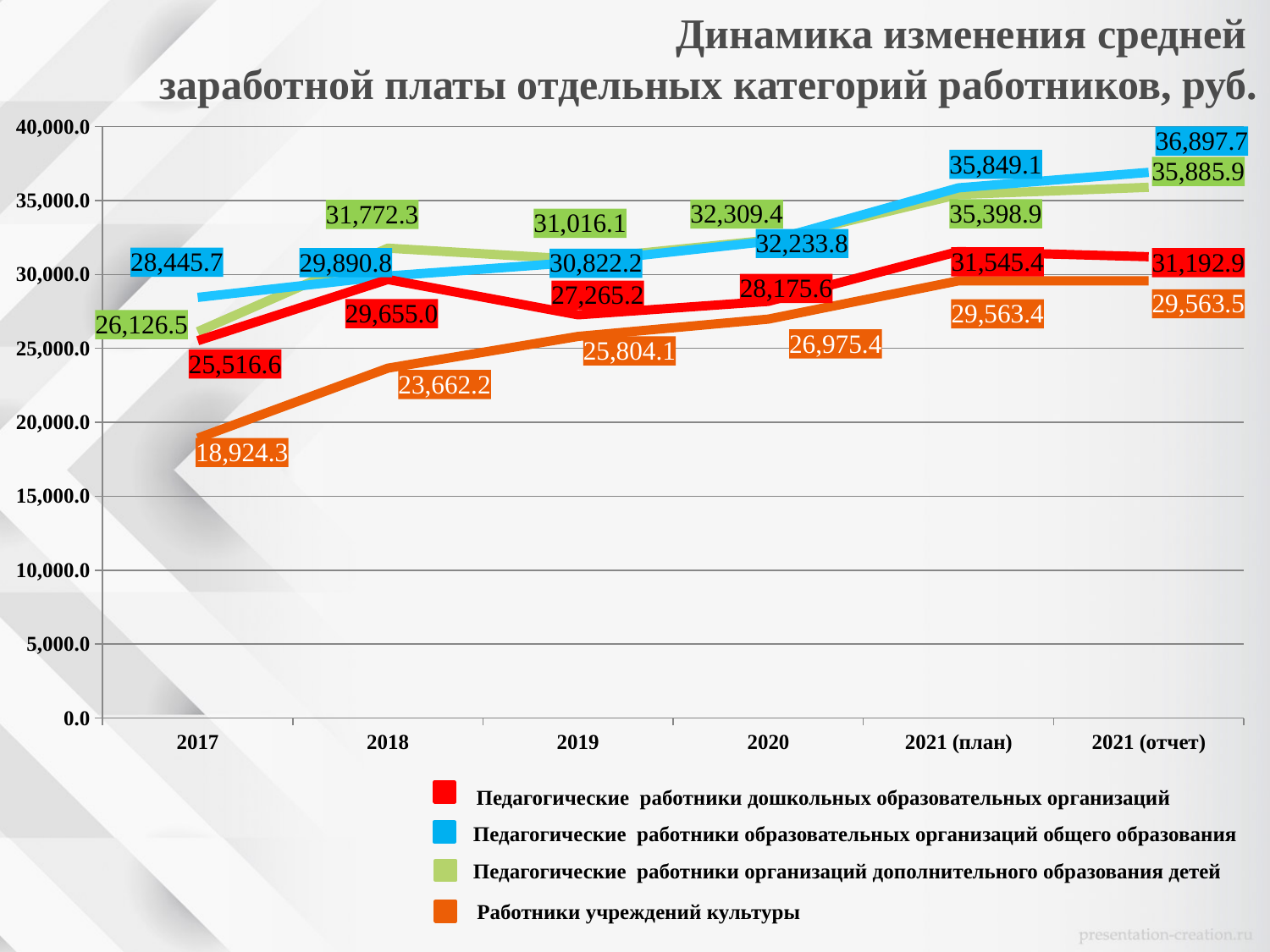
How many points along the x axis does the chart have? 6 What type of chart is shown on the slide? Line chart What is the value for Педагогические работники образовательных организаций общего образования in 2021 (отчет)? 36,897.7 How many series does the legend list? 4 Does the value for Работники учреждений культуры rise or fall from 2017 to 2021 (план)? Rise Which series has the lowest value in 2017? Работники учреждений культуры What is the difference between the 2021 (план) and 2017 values for Педагогические работники образовательных организаций общего образования? 7,403.4 What is the value for Педагогические работники дошкольных образовательных организаций in 2019? 27,265.2 Which series has the highest value in 2021 (отчет)? Педагогические работники образовательных организаций общего образования In 2018, which is larger: the value for Педагогические работники дошкольных образовательных организаций or for Педагогические работники организаций дополнительного образования детей? Педагогические работники организаций дополнительного образования детей What is the value for Работники учреждений культуры in 2017? 18,924.3 What is the value for Педагогические работники организаций дополнительного образования детей in 2018? 31,772.3